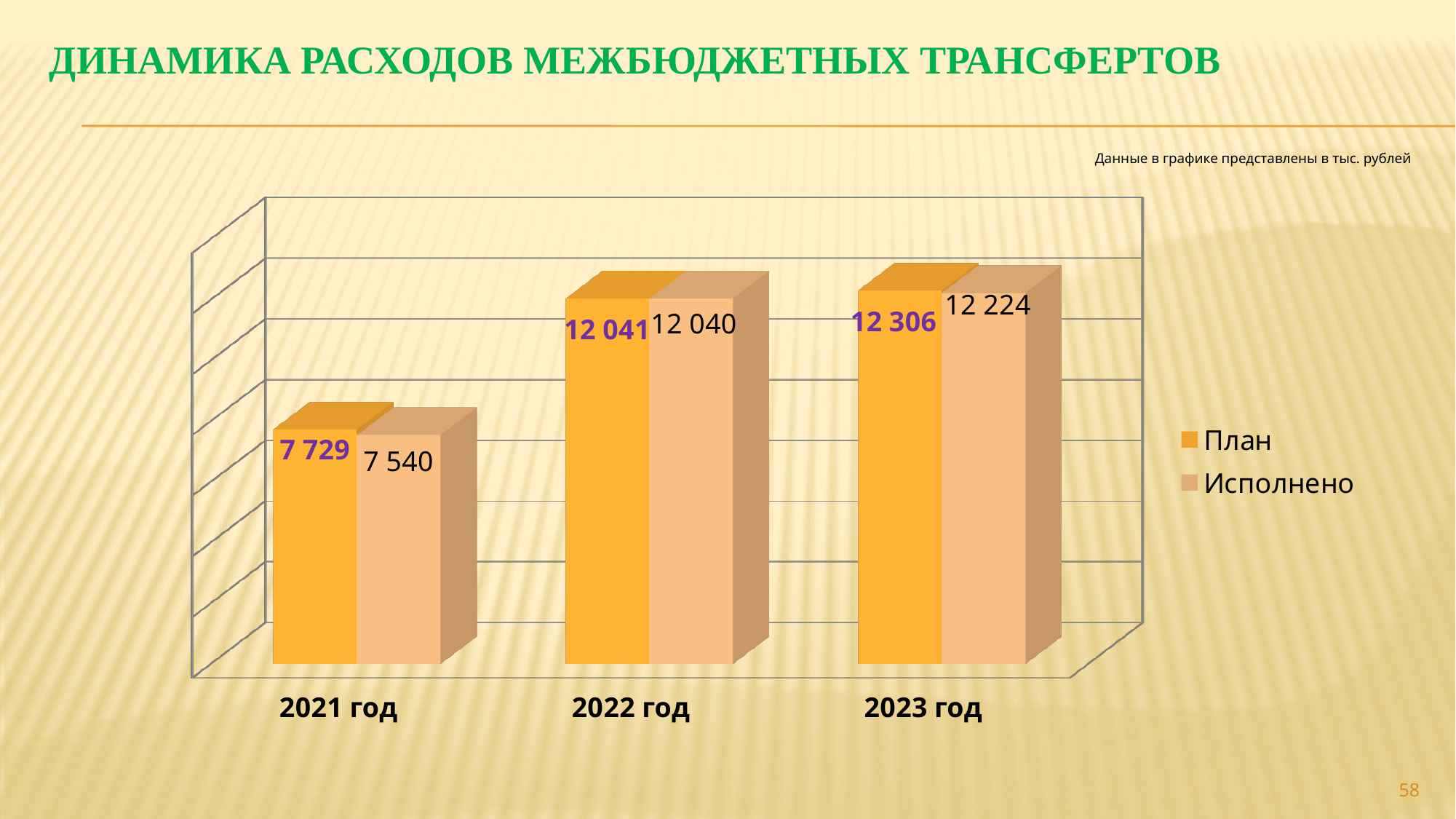
What is the Исполнено value for 2023 год? 12 224 What is the Исполнено value for 2022 год? 12 040 Which year has the highest План value? 2023 год Which is larger: the Исполнено value for 2022 год or the Исполнено value for 2021 год? 2022 год What kind of chart is shown on the slide? Bar chart How many years are shown on the x axis? 3 Do the План values rise or fall from 2021 год to 2023 год? Rise What is the План value for 2021 год? 7 729 What is the difference between the План values for 2023 год and 2022 год? 265 How many series does the legend list? 2 Which year has the lowest Исполнено value? 2021 год What is the difference between План and Исполнено for 2021 год? 189